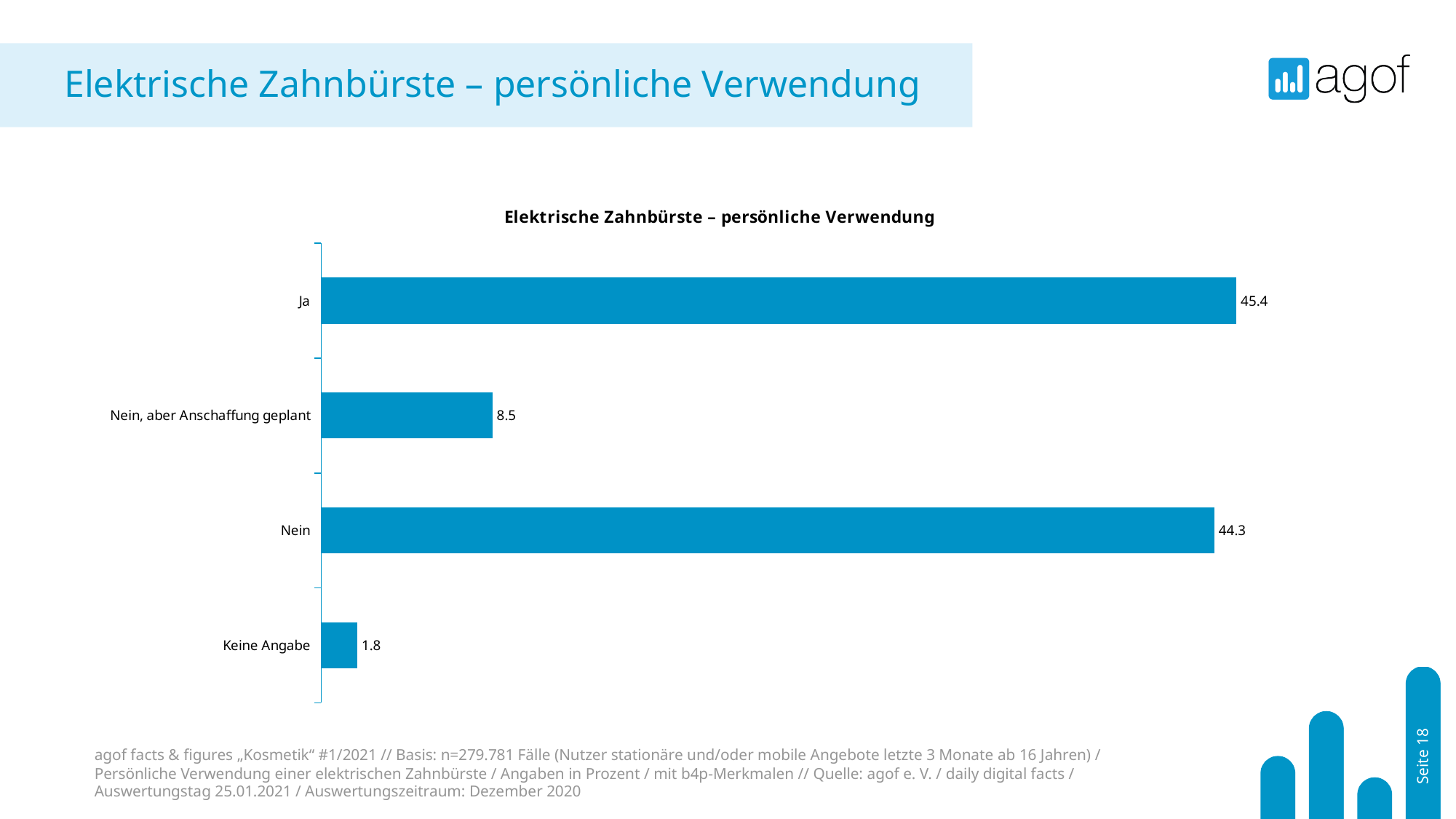
Which category has the highest value? Ja Which category has the lowest value? Keine Angabe What is the value for "Keine Angabe"? 1.8 What is the title of the chart? Elektrische Zahnbürste – persönliche Verwendung How many categories are shown in the chart? 4 What is the value for "Nein"? 44.3 What kind of chart is shown on the slide? Bar chart Which is larger, the value for "Nein, aber Anschaffung geplant" or the value for "Keine Angabe"? Nein, aber Anschaffung geplant What is the value for "Nein, aber Anschaffung geplant"? 8.5 What is the difference between the values for "Ja" and "Nein"? 1.1 What is the difference between the values for "Nein, aber Anschaffung geplant" and "Keine Angabe"? 6.7 What is the value for "Ja"? 45.4